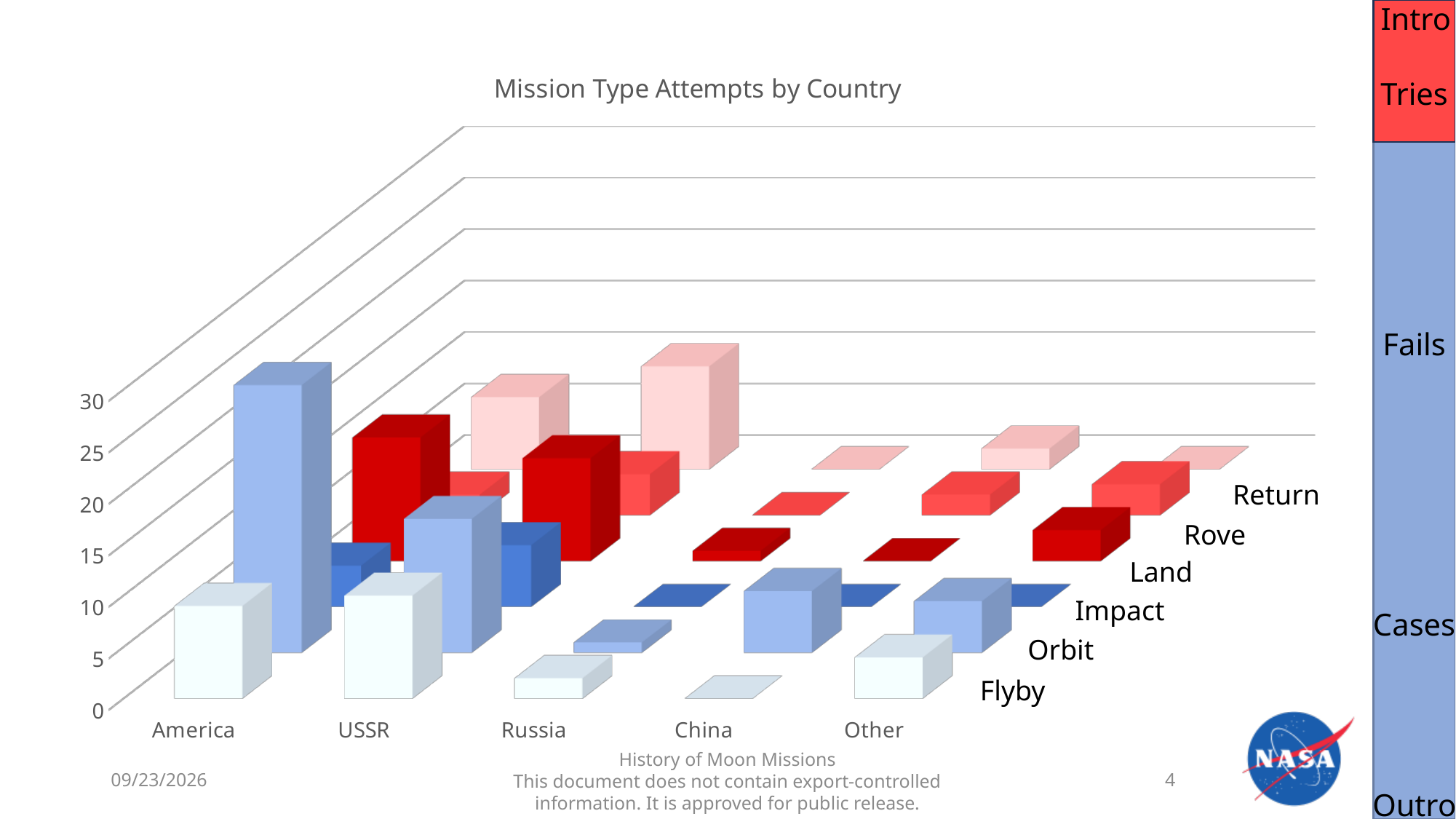
Which country has the lowest Flyby value? China Is the Orbit value for America greater or less than 20? greater What kind of chart is shown on the slide? bar chart Is the Flyby value for China greater or less than 5? less Which country has the tallest Orbit bar? America Which is larger, the Orbit value for America or the Orbit value for USSR? America Which is larger, the Orbit value for China or the Orbit value for Russia? China What is the highest value labelled on the vertical axis? 30 Which country has the lowest Orbit value? Russia How many mission types (series) does the chart show? 6 What is the title of the chart? Mission Type Attempts by Country How many countries are shown along the x axis of the chart? 5